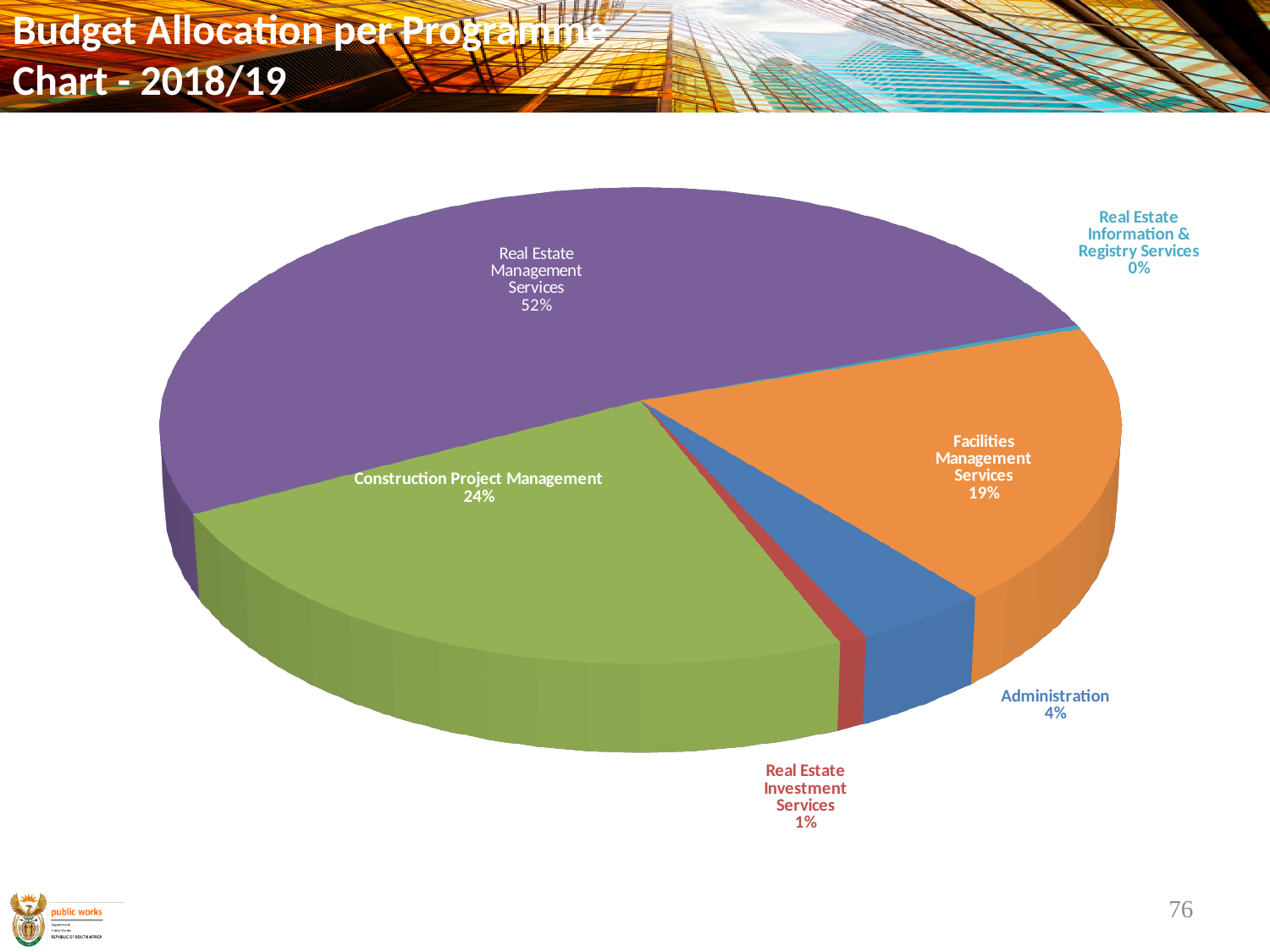
What is the difference in percentage points between Real Estate Management Services and Construction Project Management? 28 What share of the budget is allocated to Real Estate Investment Services? 1% What share of the budget is allocated to Facilities Management Services? 19% Which programme receives the largest share of the budget? Real Estate Management Services Which programme receives the smallest share of the budget? Real Estate Information & Registry Services Which receives a larger share of the budget, Facilities Management Services or Administration? Facilities Management Services What share of the budget is allocated to Construction Project Management? 24% What share of the budget is allocated to Real Estate Management Services? 52% What share of the budget is allocated to Administration? 4% How many programmes are shown in the pie chart? 6 What is the title of the chart on the slide? Budget Allocation per Programme Chart - 2018/19 What kind of chart is shown on the slide? Pie chart